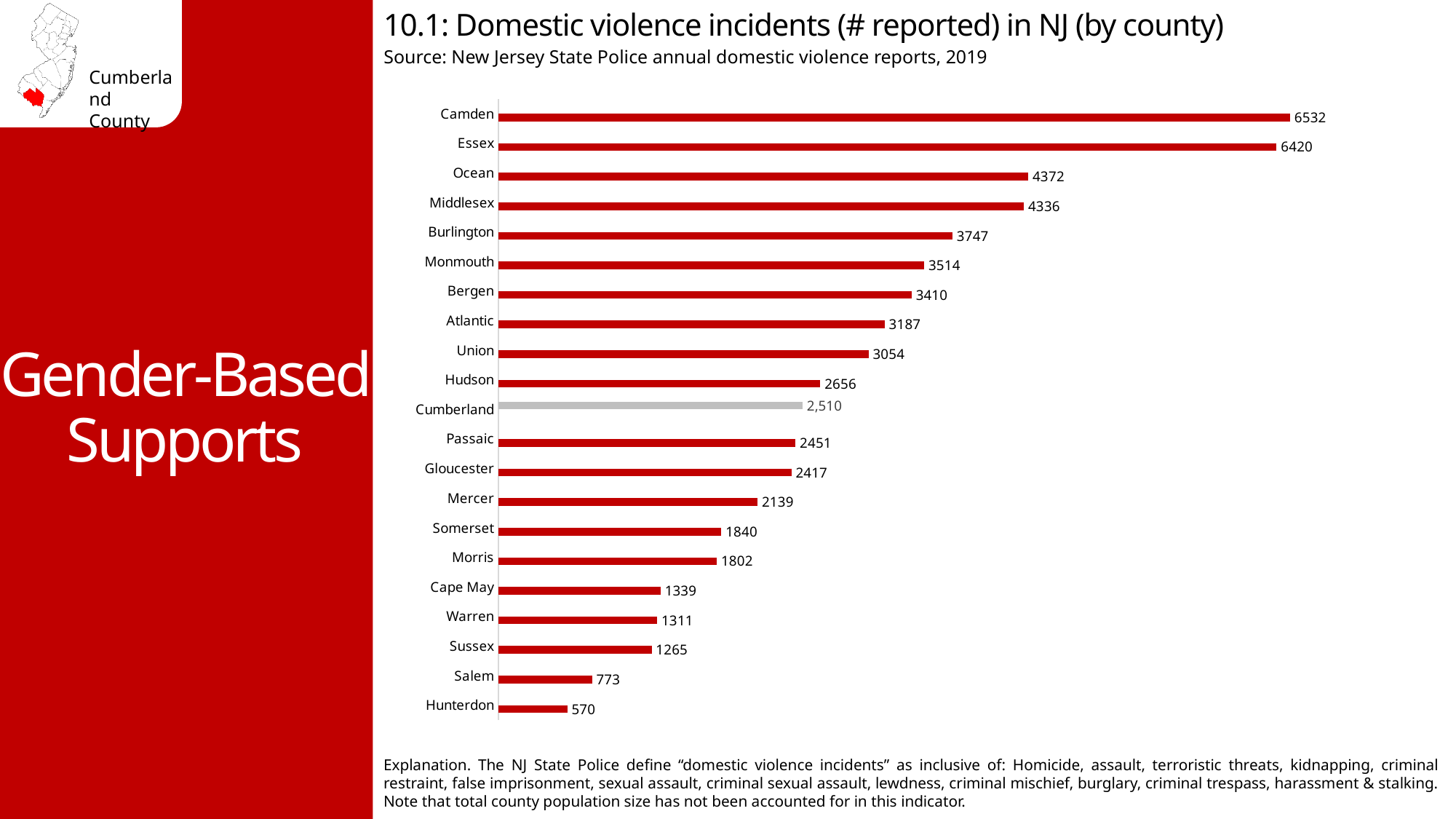
What is the difference between the number of incidents in Camden and Essex? 112 What is the difference between the number of incidents in Cumberland and Passaic? 59 What is the number of reported domestic violence incidents for Hunterdon? 570 Which county has more reported incidents, Ocean or Middlesex? Ocean Which county has the lowest number of reported domestic violence incidents? Hunterdon Which county has more reported incidents, Salem or Sussex? Sussex Which county's bar is shown in grey rather than red? Cumberland How many counties are shown in the chart? 21 Which county has the highest number of reported domestic violence incidents? Camden What is the number of reported domestic violence incidents for Camden? 6532 What is the number of reported domestic violence incidents for Cumberland? 2,510 What kind of chart is shown on the slide? Bar chart